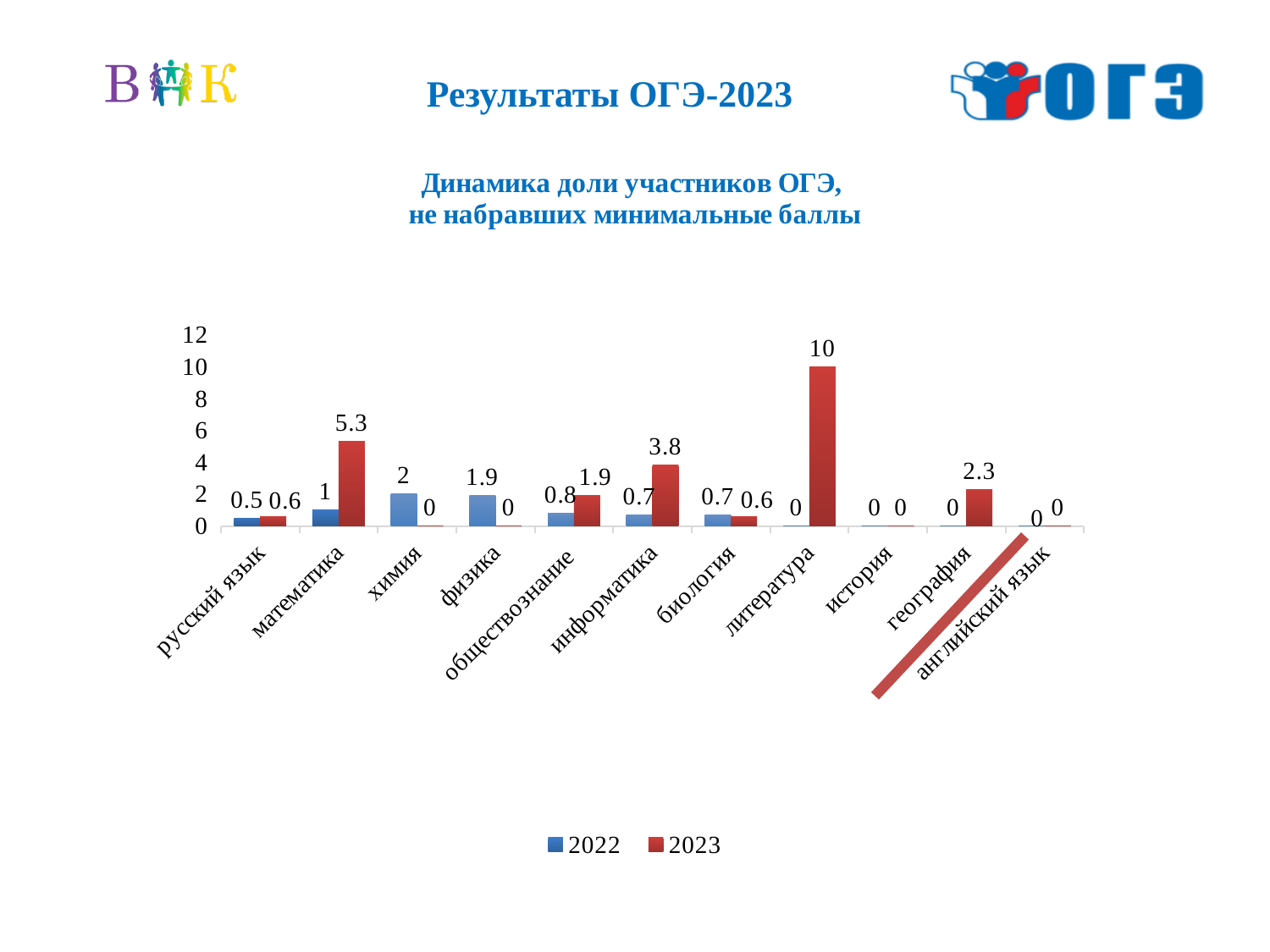
How many categories are shown on the x axis? 11 What is the 2023 value for математика? 5.3 What kind of chart is shown on the slide? bar chart What is the difference between the 2023 and 2022 values for математика? 4.3 What is the 2023 value for информатика? 3.8 What is the title of the chart? Динамика доли участников ОГЭ, не набравших минимальные баллы Which category has the highest 2023 value? литература How many series does the legend list? 2 Which category has the highest 2022 value? химия What is the 2022 value for химия? 2 Which is larger for биология: the 2022 value or the 2023 value? 2022 What is the 2023 value for география? 2.3